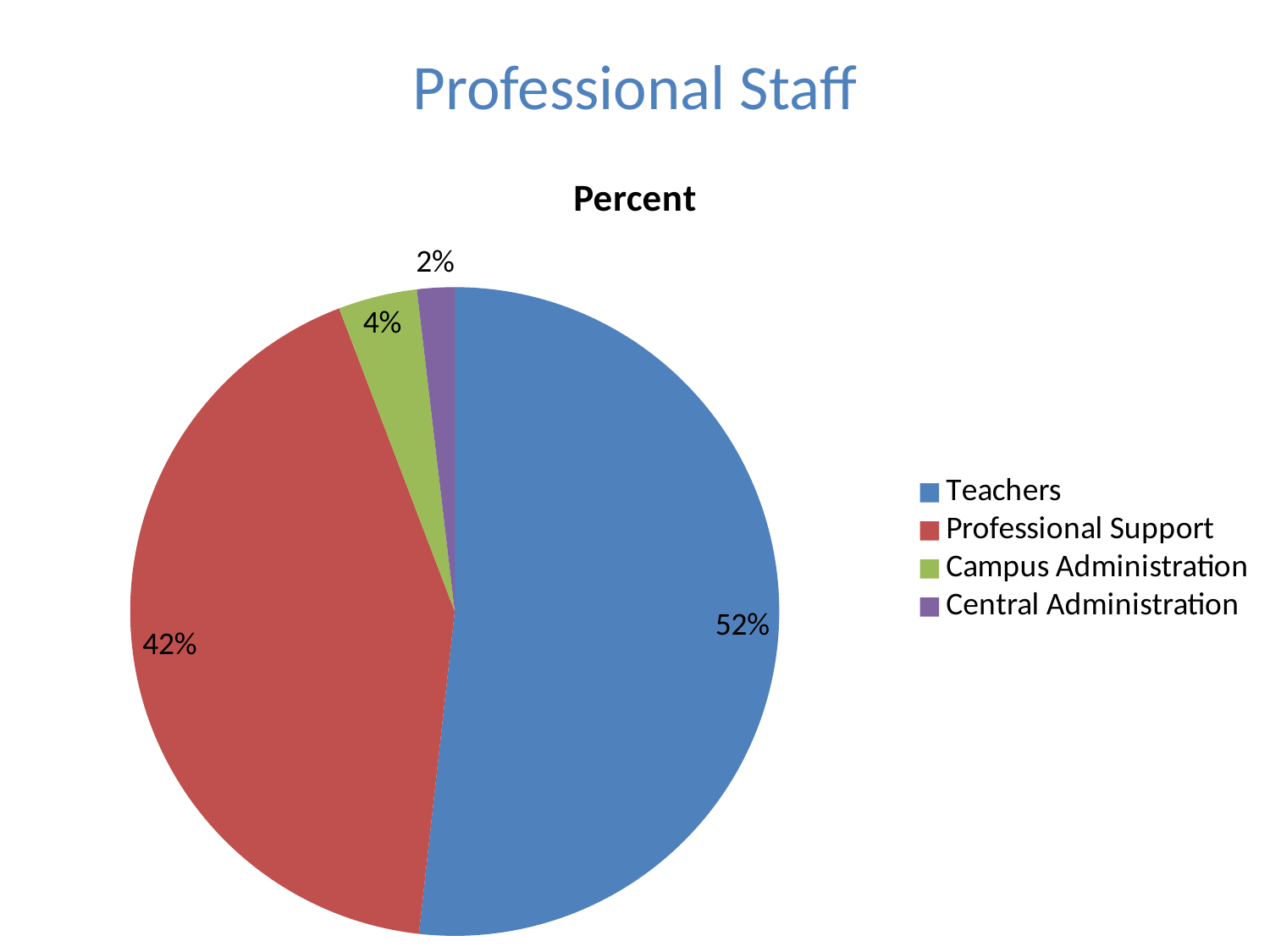
How many categories are shown in the pie chart? 4 What is the difference in percentage points between Teachers and Professional Support? 10 What percentage of professional staff are Professional Support? 42% Which category has the smallest share of the pie? Central Administration What is the title of the chart? Percent What kind of chart is shown on the slide? Pie chart What colour is the slice for Professional Support? Red Which category has the largest share of the pie? Teachers What percentage of professional staff are Teachers? 52% What percentage of professional staff are Campus Administration? 4% Which is larger, the share for Campus Administration or the share for Central Administration? Campus Administration What percentage of professional staff are Central Administration? 2%